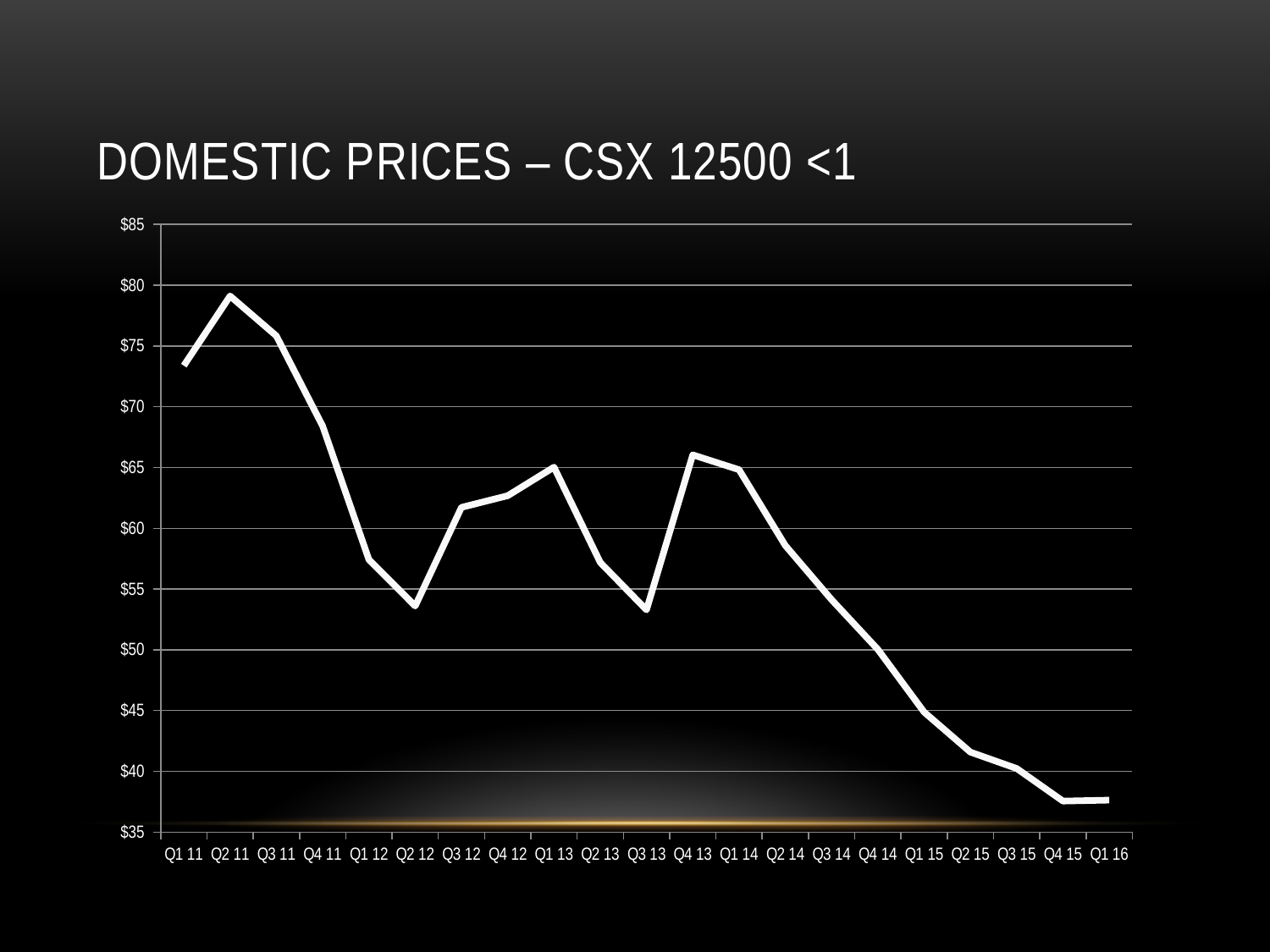
How many quarters are plotted along the x axis? 21 Which is larger, the value for Q2 11 or the value for Q1 16? Q2 11 Is the value for Q1 16 greater or less than $40? less Is the value for Q2 12 greater or less than $55? less Is the value for Q2 11 greater or less than $75? greater Overall, do the values rise or fall from Q1 11 to Q1 16? fall What kind of chart is shown on the slide? line chart Which quarter has the highest value? Q2 11 What is the title of the chart? DOMESTIC PRICES – CSX 12500 <1 Which is larger, the value for Q3 13 or the value for Q4 13? Q4 13